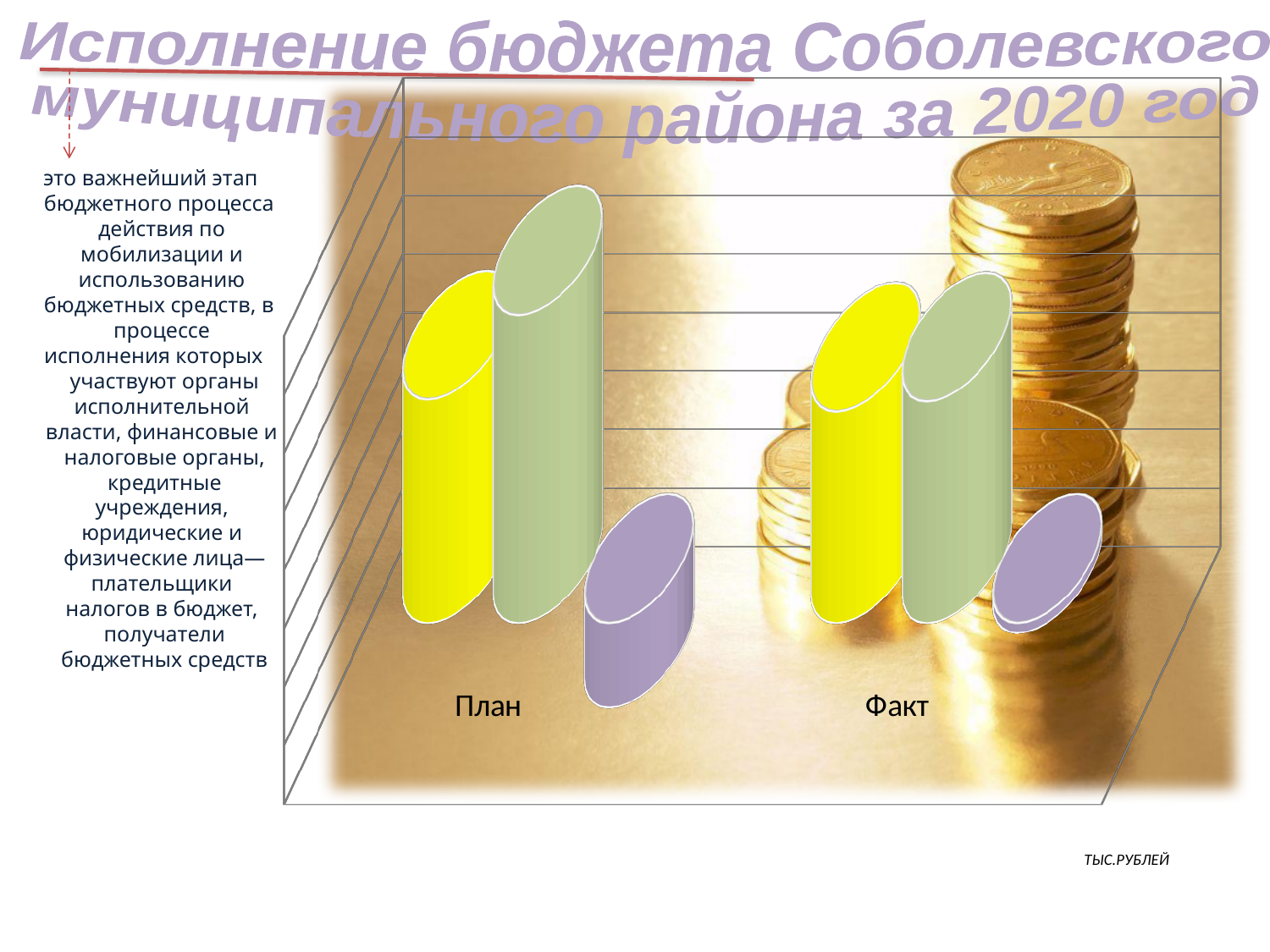
Within the category План, which bar is the tallest: the yellow, green or purple one? green Within the category Факт, which bar is the shortest: the yellow, green or purple one? purple Within the category Факт, is the purple bar taller or shorter than the yellow bar? shorter How many bars are plotted for the category План? 3 How many categories are shown on the x axis of the chart? 2 How many bars are plotted for the category Факт? 3 What are the two category labels on the x axis of the chart? План and Факт What unit is indicated in the bottom-right corner of the chart? ТЫС.РУБЛЕЙ Within the category План, is the green bar taller or shorter than the yellow bar? taller Within the category План, which bar is the shortest: the yellow, green or purple one? purple What kind of chart is shown on the slide? bar chart